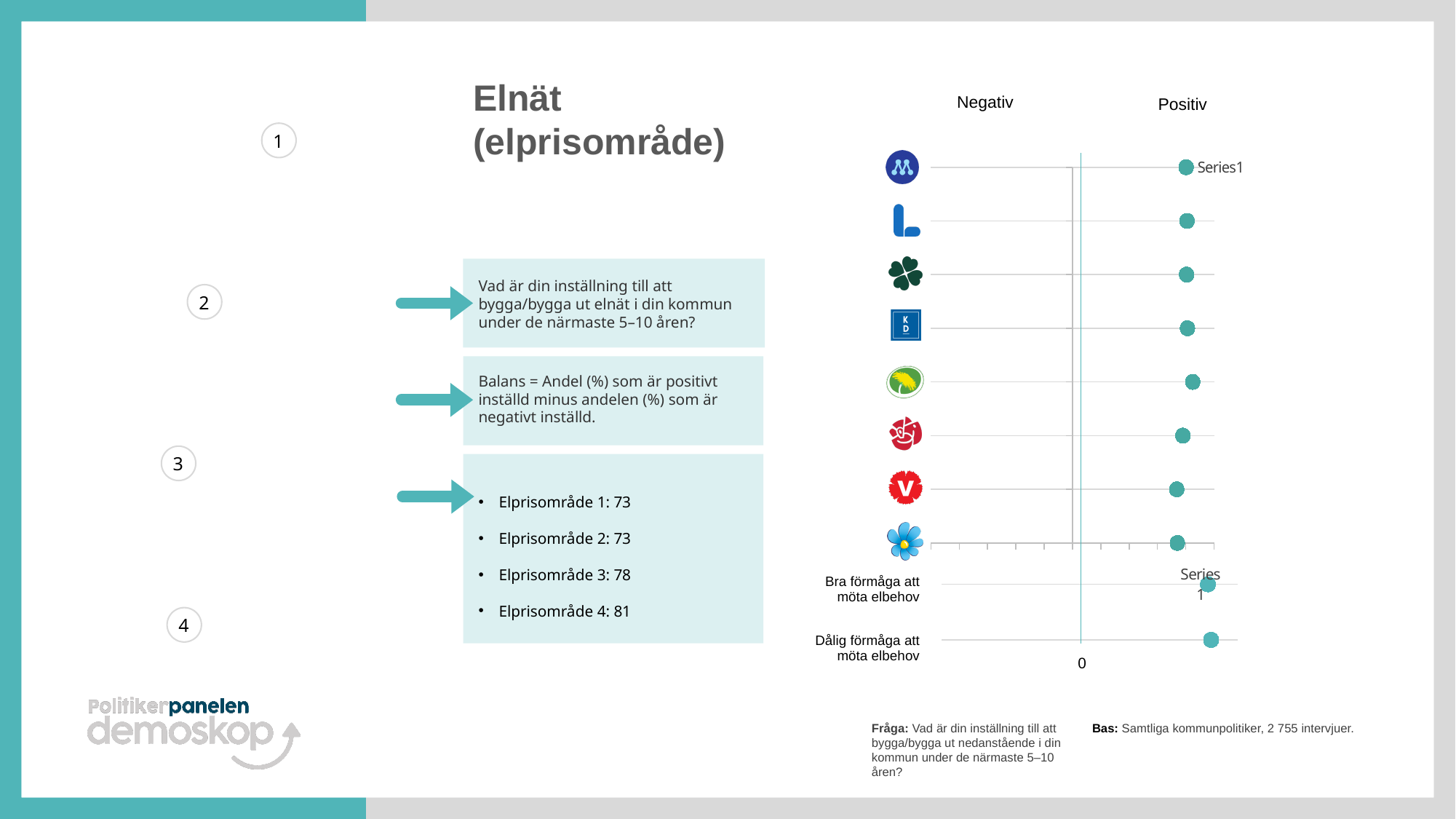
Is the value for "Dålig förmåga att möta elbehov" greater or less than 0? greater Is the value for "Bra förmåga att möta elbehov" greater or less than 0? greater Are any of the plotted points on the "Negativ" side of the 0 line? No How many data points are plotted in the chart? 10